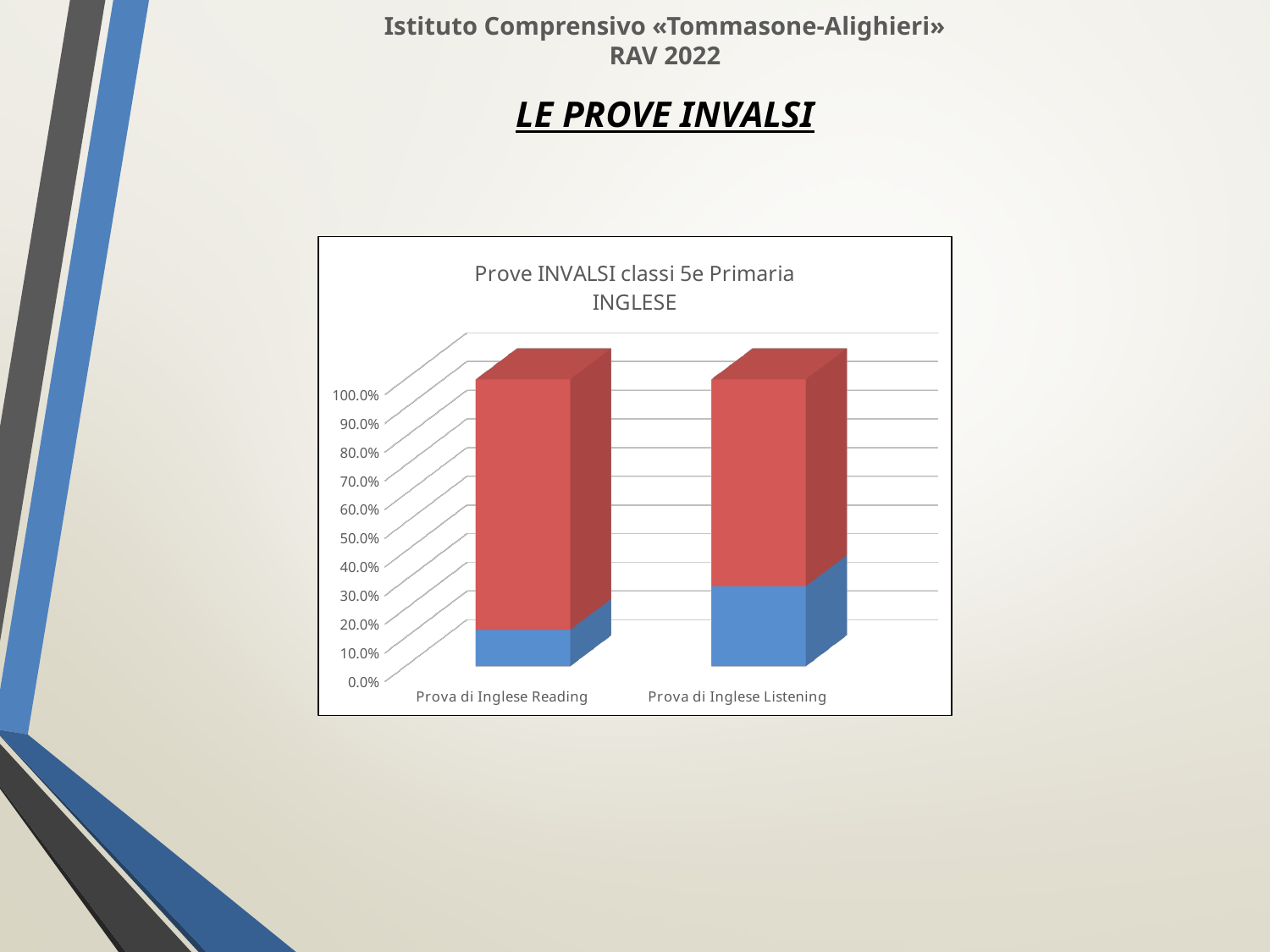
What kind of chart is shown on the slide? Stacked bar chart What is the highest value shown on the vertical axis of the chart? 100.0% How many categories are shown on the x axis of the chart? 2 Is the red segment for Prova di Inglese Reading greater or less than 70.0%? greater What is the title of the chart? Prove INVALSI classi 5e Primaria INGLESE Is the blue segment for Prova di Inglese Reading greater or less than 30.0%? less Is the red segment for Prova di Inglese Listening greater or less than 50.0%? greater Which category has the larger red segment, Prova di Inglese Reading or Prova di Inglese Listening? Prova di Inglese Reading Which category has the larger blue segment, Prova di Inglese Reading or Prova di Inglese Listening? Prova di Inglese Listening What are the two categories shown on the x axis? Prova di Inglese Reading, Prova di Inglese Listening